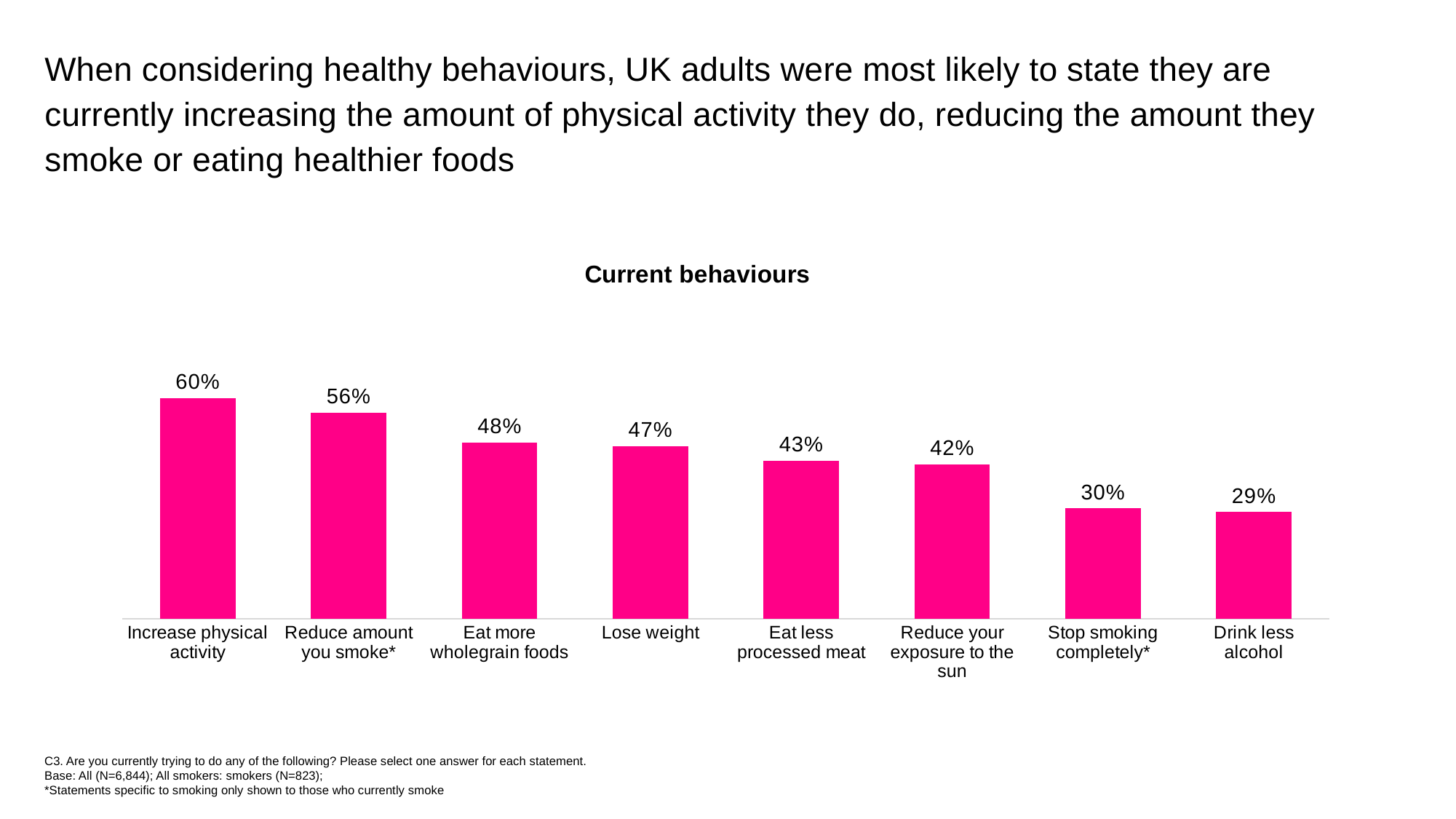
What percentage of UK adults say they are currently trying to increase physical activity? 60% What is the title of the chart? Current behaviours What is the value shown for 'Eat less processed meat'? 43% Do the values rise or fall moving from left to right across the chart? Fall What is the difference between the values for 'Increase physical activity' and 'Reduce amount you smoke*'? 4 percentage points Which behaviour has the lowest percentage in the chart? Drink less alcohol What is the difference between the values for 'Eat more wholegrain foods' and 'Stop smoking completely*'? 18 percentage points What type of chart is used on this slide? Bar chart Which behaviour has the highest percentage in the chart? Increase physical activity What is the value shown for 'Drink less alcohol'? 29% Which is larger: the value for 'Lose weight' or the value for 'Reduce your exposure to the sun'? Lose weight How many behaviours are shown in the chart? 8